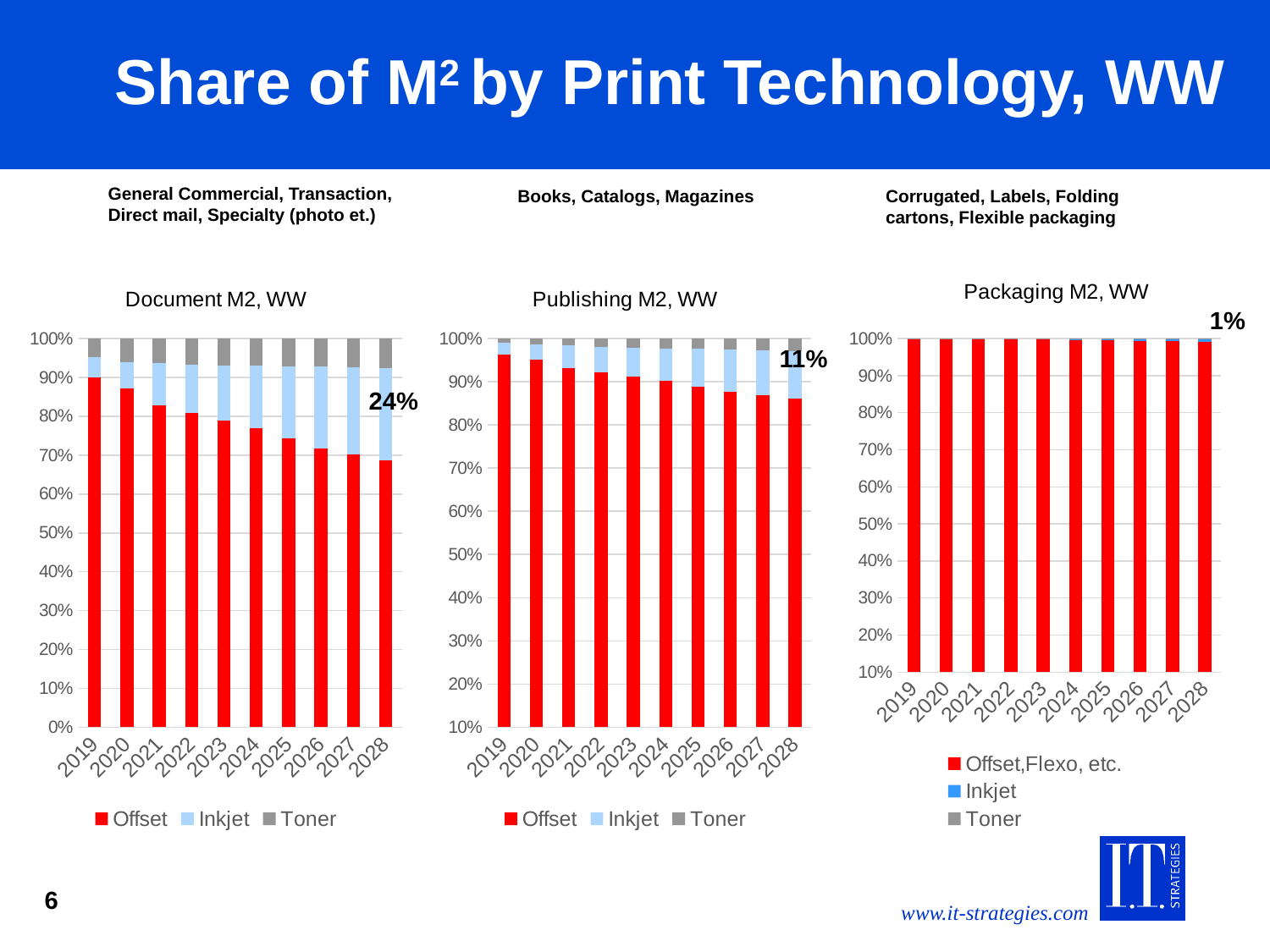
On the Publishing M2, WW chart, what percentage label is printed next to the 2028 bar? 11% On the Publishing M2, WW chart, does the Offset share rise or fall from 2019 to 2028? Fall How many years are shown on the x axis of the Publishing M2, WW chart? 10 What is the first legend entry on the Packaging M2, WW chart? Offset,Flexo, etc. On the Document M2, WW chart, is the Offset share for 2019 greater or less than 80%? greater On the Document M2, WW chart, what percentage label is printed next to the 2028 bar? 24% On the Document M2, WW chart, which year has the highest Offset share? 2019 What kind of chart is the Document M2, WW chart? Stacked bar chart How many series does the legend of the Packaging M2, WW chart list? 3 On the Document M2, WW chart, is the Offset share for 2028 greater or less than 80%? less On the Packaging M2, WW chart, what percentage label is printed above the 2028 bar? 1% On the Document M2, WW chart, does the Offset share rise or fall from 2019 to 2028? Fall